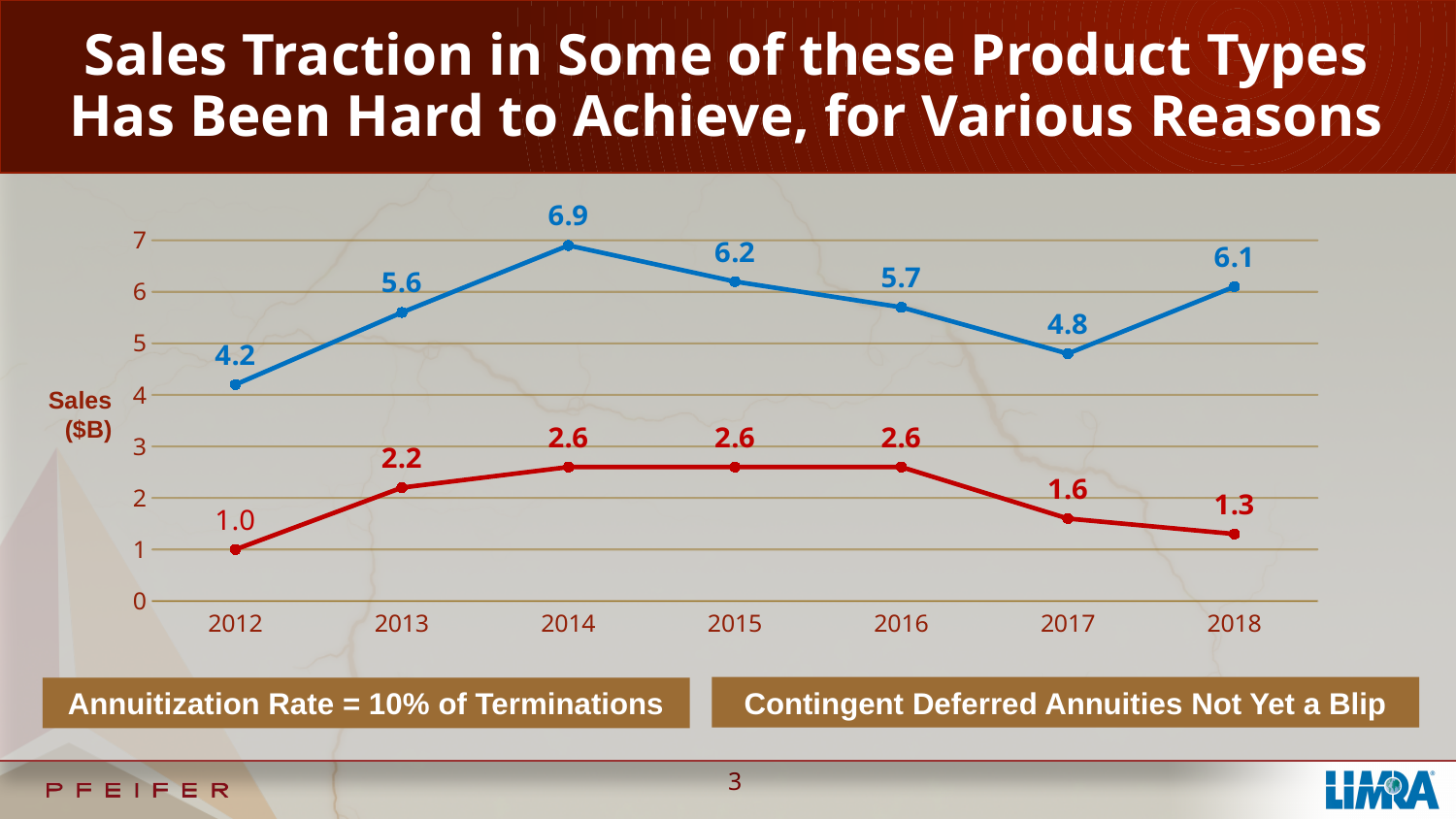
Which is larger, the blue line's value in 2015 or its value in 2016? 2015 How many years are shown on the x axis? 7 In which year does the red line have its lowest value? 2012 What is the value of the red line in 2012? 1.0 What type of chart is shown on the slide? Line chart Does the red line rise or fall from 2016 to 2018? Fall What is the value of the blue line in 2014? 6.9 What is the value of the red line in 2018? 1.3 In which year does the blue line reach its highest value? 2014 What is the label on the y axis? Sales ($B) What is the difference between the blue line and the red line in 2018? 4.8 What is the value of the blue line in 2017? 4.8